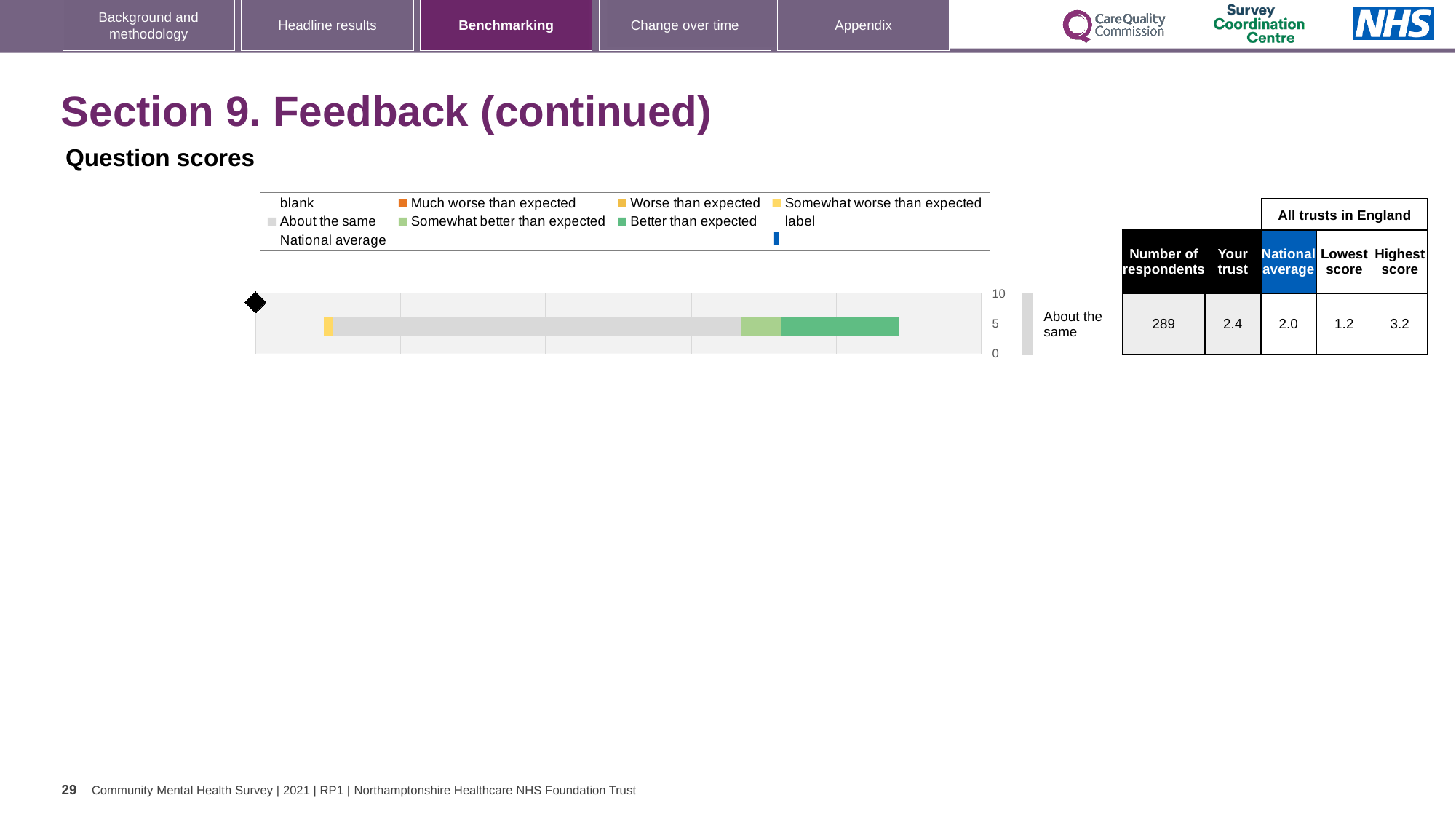
What is the highest value shown on the chart's axis? 10 What kind of chart is shown under 'Question scores'? bar chart In the table next to the chart, what is the National average score? 2.0 In the table next to the chart, what is the number of respondents? 289 In the table next to the chart, what is the difference between the Highest score and the Lowest score? 2.0 In the table next to the chart, what is the 'Your trust' score? 2.4 In the table next to the chart, what is the difference between the 'Your trust' score and the National average? 0.4 In the table next to the chart, which is larger: the 'Your trust' score or the National average? Your trust In the table next to the chart, what is the Highest score for all trusts in England? 3.2 In the table next to the chart, what is the Lowest score for all trusts in England? 1.2 What is the category label shown to the right of the bar in the chart? About the same How many bars are plotted in the chart? 1